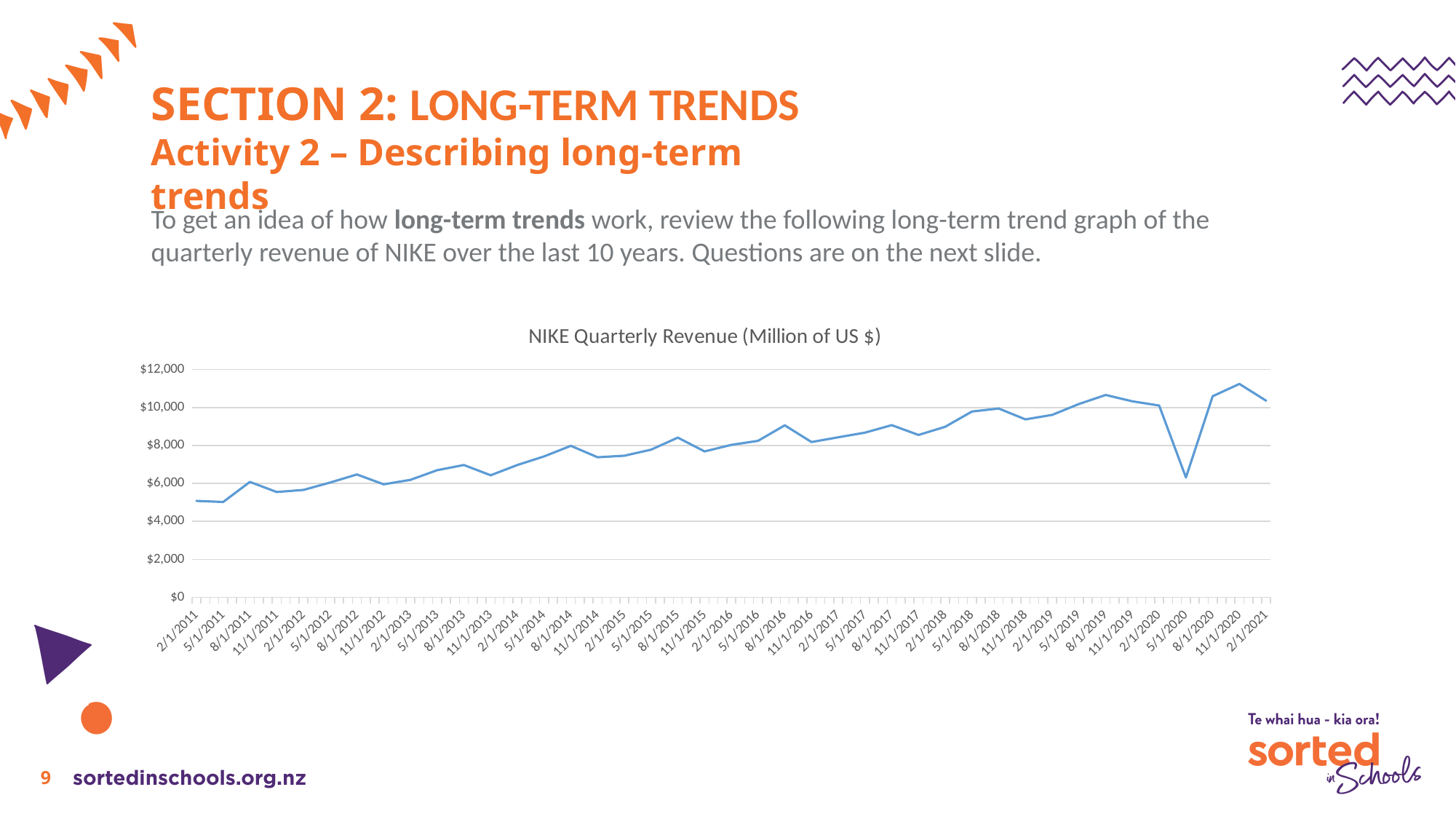
Which quarter has the highest revenue on the chart? 11/1/2020 Overall, do NIKE's quarterly revenues rise or fall from 2/1/2011 to 2/1/2021? rise What is the title of the chart? NIKE Quarterly Revenue (Million of US $) Is the revenue for 11/1/2020 greater or less than $10,000? greater Which quarter has the higher revenue, 2/1/2011 or 8/1/2019? 8/1/2019 Is the revenue for 8/1/2016 greater or less than $8,000? greater Is the revenue for 8/1/2018 greater or less than $8,000? greater What kind of chart is shown on the slide? line chart How many quarterly data points are plotted on the chart? 41 Which quarter has the higher revenue, 5/1/2020 or 11/1/2020? 11/1/2020